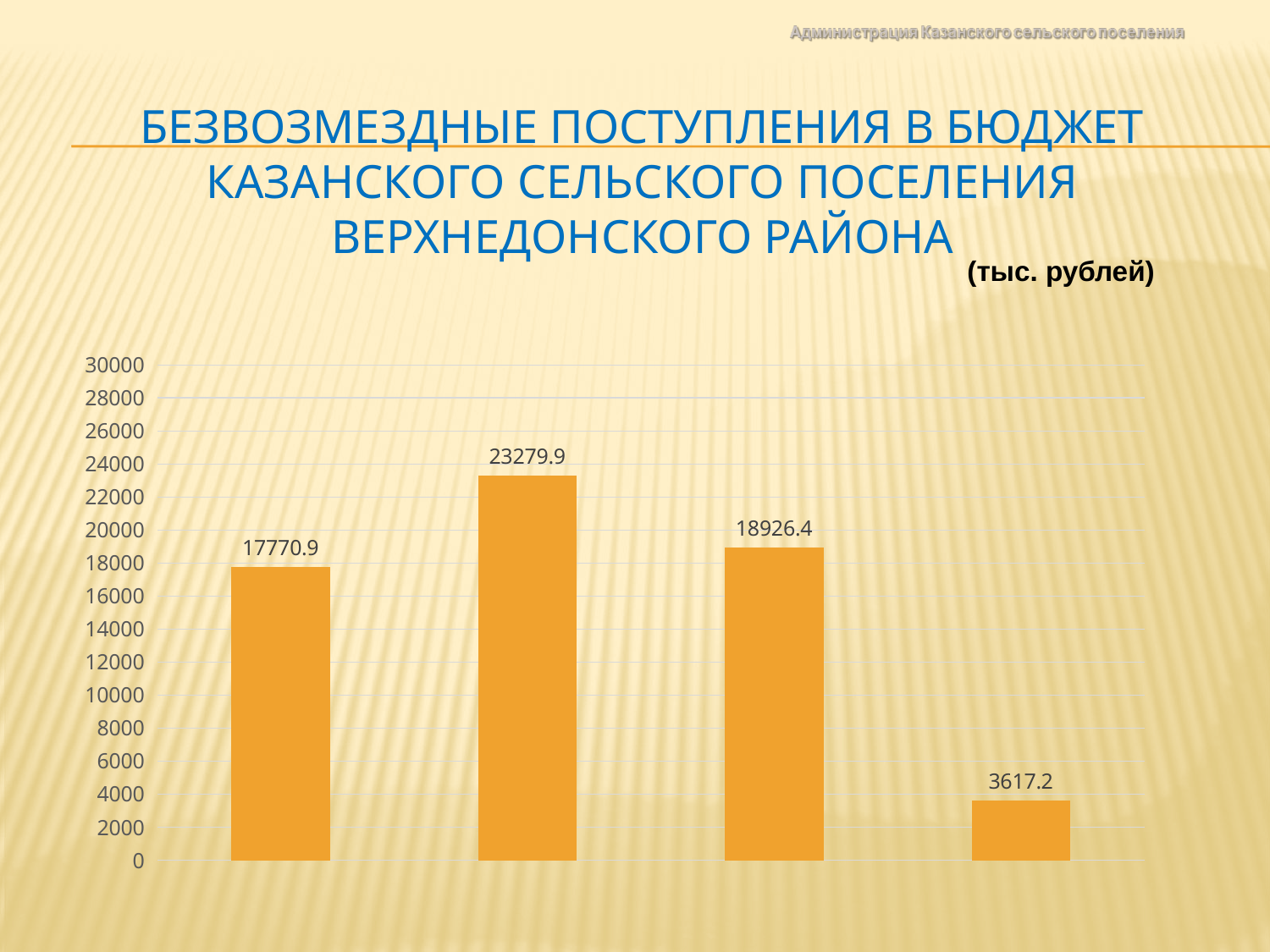
Which bar has the lowest value? The fourth (rightmost) bar (3617.2) Is the value of the rightmost bar greater or less than 4000? less Which is larger, the first bar or the third bar? The third bar (18926.4) What is the value of the third bar from the left? 18926.4 What is the value of the fourth (rightmost) bar? 3617.2 What is the value of the first bar from the left? 17770.9 Which bar has the highest value? The second bar from the left (23279.9) What is the value of the second bar from the left? 23279.9 What type of chart is shown on the slide? Bar chart How many bars are shown in the chart? 4 What is the difference between the second bar (23279.9) and the third bar (18926.4)? 4353.5 In what units are the values on the chart given, according to the slide? тыс. рублей